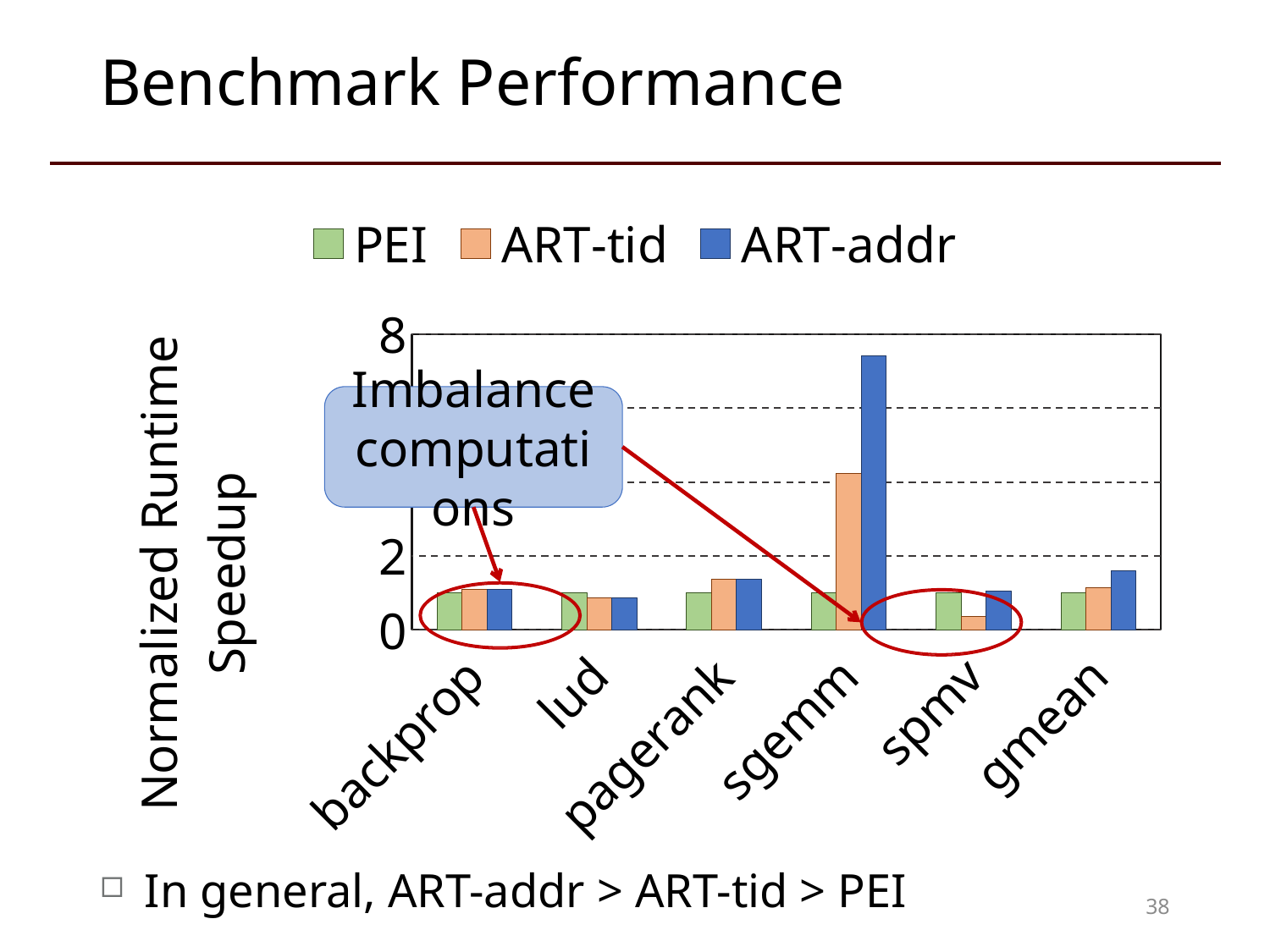
Which category has the highest ART-addr value? sgemm Is the PEI value for pagerank greater or less than 2? less For spmv, which is larger: the ART-tid value or the ART-addr value? ART-addr What kind of chart is shown on the slide? bar chart Is the ART-addr value for sgemm greater or less than 6? greater How many benchmark categories are shown on the x axis? 6 Which category has the lowest ART-tid value? spmv For sgemm, which is larger: the ART-tid value or the ART-addr value? ART-addr What is the label on the y axis of the chart? Normalized Runtime Speedup How many series does the legend list? 3 Is the ART-tid value for spmv greater or less than 2? less